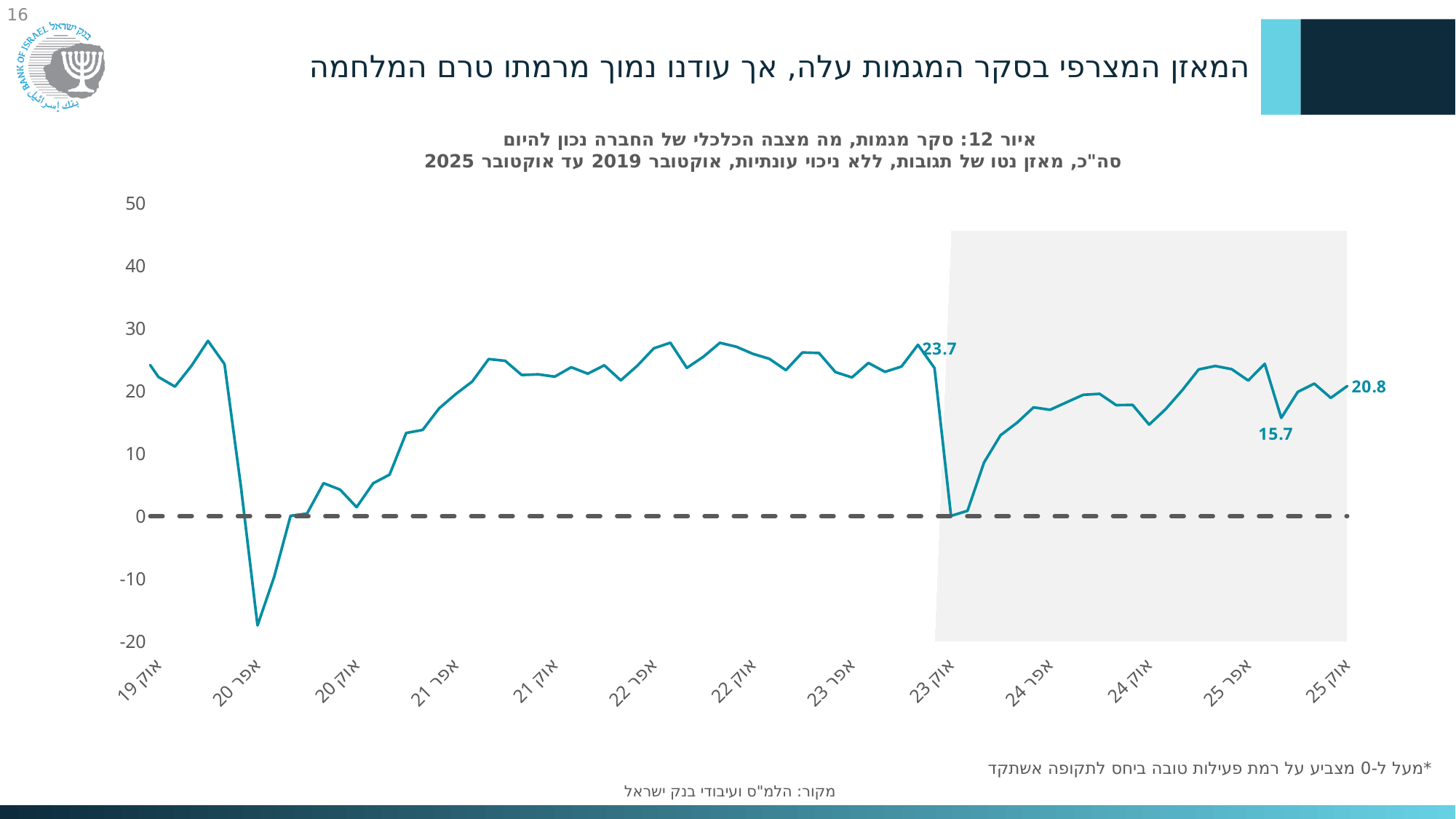
What type of chart is shown on the slide? line chart What is the highest value shown on the y axis? 50 How many labels are shown on the x axis? 13 What is the labelled value of the series at אוק 23? 23.7 Is the value of the line at אוק 22 greater or less than 20? greater What is the lowest labelled value shown in the shaded period after אוק 23? 15.7 Which is larger: the labelled value at אוק 23 or the labelled value at אוק 25? אוק 23 At what value is the horizontal dashed line drawn? 0 What is the labelled value of the series at אוק 25, the last point? 20.8 Is the lowest point of the line, shortly after אפר 20, greater or less than -10? less What is the difference between the labelled value at אוק 23 (23.7) and the labelled value at אוק 25 (20.8)? 2.9 Does the line rise or fall between אוק 23 and אפר 24? rise